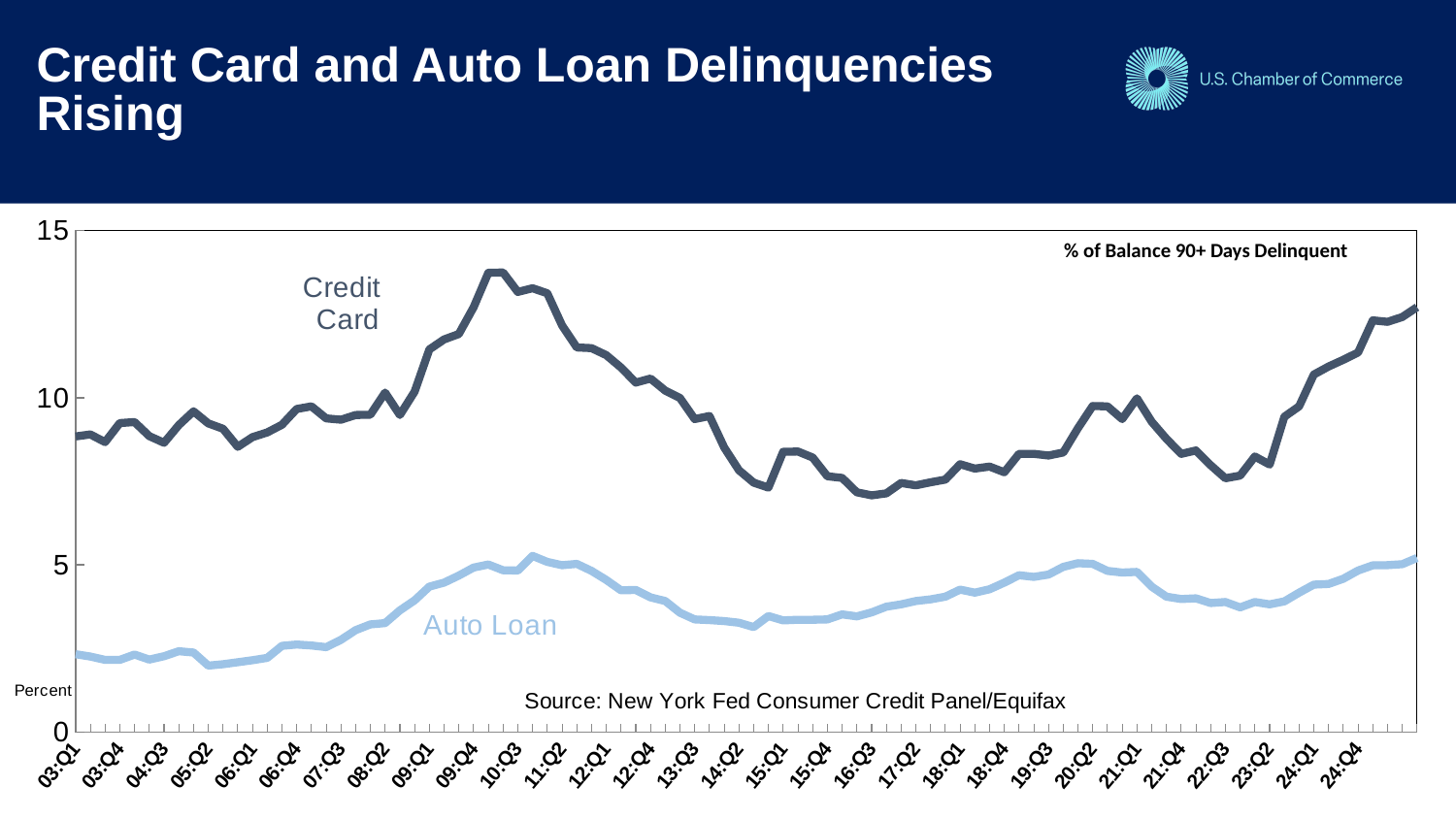
What is the source cited on the chart? New York Fed Consumer Credit Panel/Equifax Is the Auto Loan value at 03:Q1 greater or less than 5? less Which series stays lower throughout the chart? Auto Loan What kind of chart is shown on the slide? line chart At 15:Q1, which series has the larger value, Credit Card or Auto Loan? Credit Card How many series are plotted on the chart? 2 Is the Credit Card value at 16:Q3 greater or less than 10? less Does the Credit Card series rise or fall between 22:Q3 and 24:Q4? rise Which series reaches the highest value on the chart? Credit Card Does the Credit Card series rise or fall between 10:Q1 and 16:Q3? fall Is the Credit Card value at 10:Q1 greater or less than 10? greater